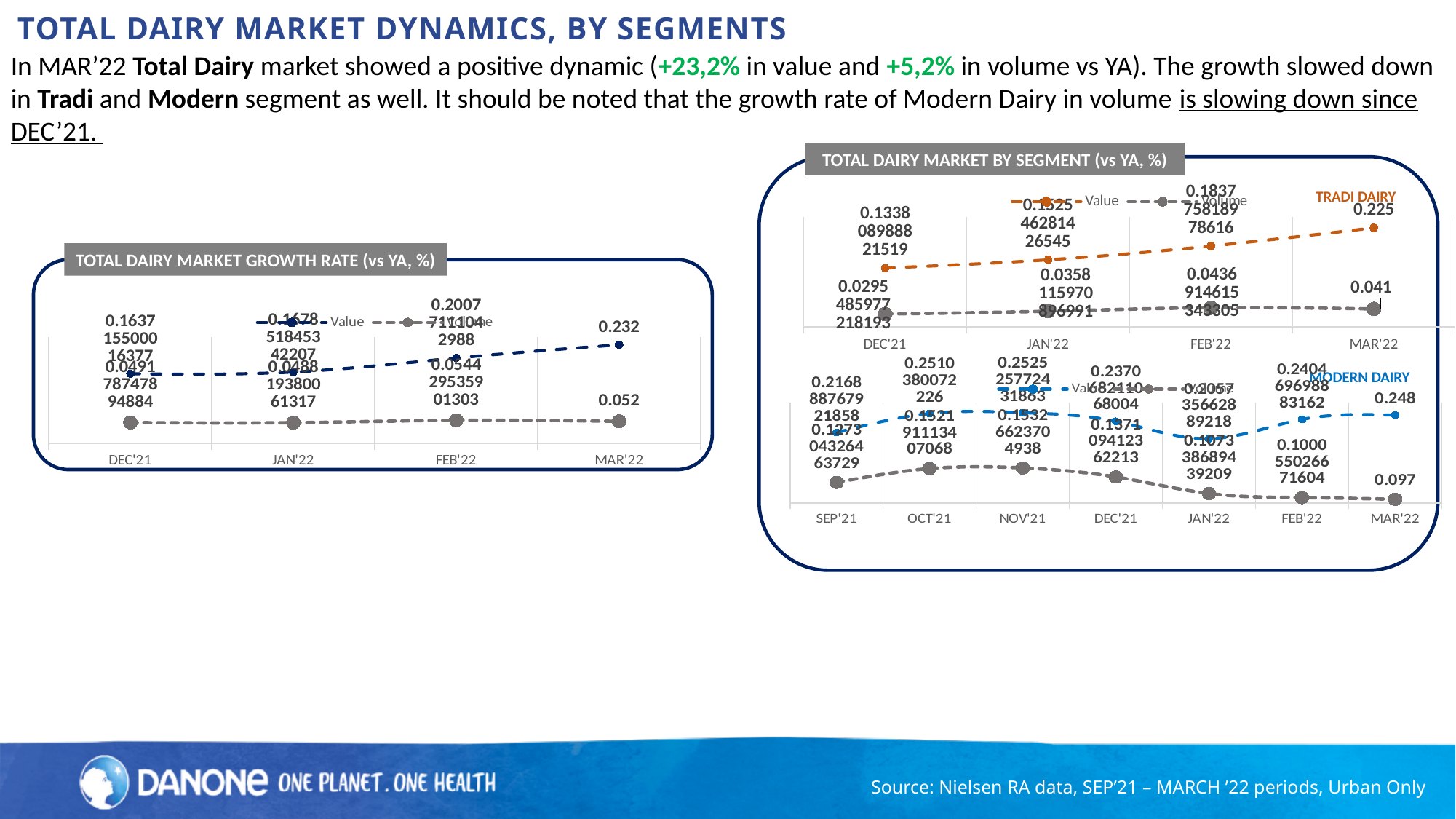
In the MODERN DAIRY chart, what is the Volume growth rate for MAR'22? 0.097 How many periods are shown on the x axis of the TOTAL DAIRY MARKET GROWTH RATE chart? 4 In the TOTAL DAIRY MARKET GROWTH RATE chart, does the Value series rise or fall from DEC'21 to MAR'22? rise For MAR'22, which segment has the higher Value growth rate, TRADI DAIRY or MODERN DAIRY? MODERN DAIRY In the TRADI DAIRY chart, what is the Volume growth rate for MAR'22? 0.041 In the TOTAL DAIRY MARKET GROWTH RATE chart, what is the Volume growth rate for MAR'22? 0.052 What kind of chart is the TOTAL DAIRY MARKET GROWTH RATE chart? line chart How many periods are shown on the x axis of the MODERN DAIRY chart? 7 In the MODERN DAIRY chart, what is the Value growth rate for MAR'22? 0.248 In the TRADI DAIRY chart, what is the Value growth rate for MAR'22? 0.225 How many series does the legend of the TOTAL DAIRY MARKET GROWTH RATE chart list? 2 In the TOTAL DAIRY MARKET GROWTH RATE chart, what is the Value growth rate for MAR'22? 0.232